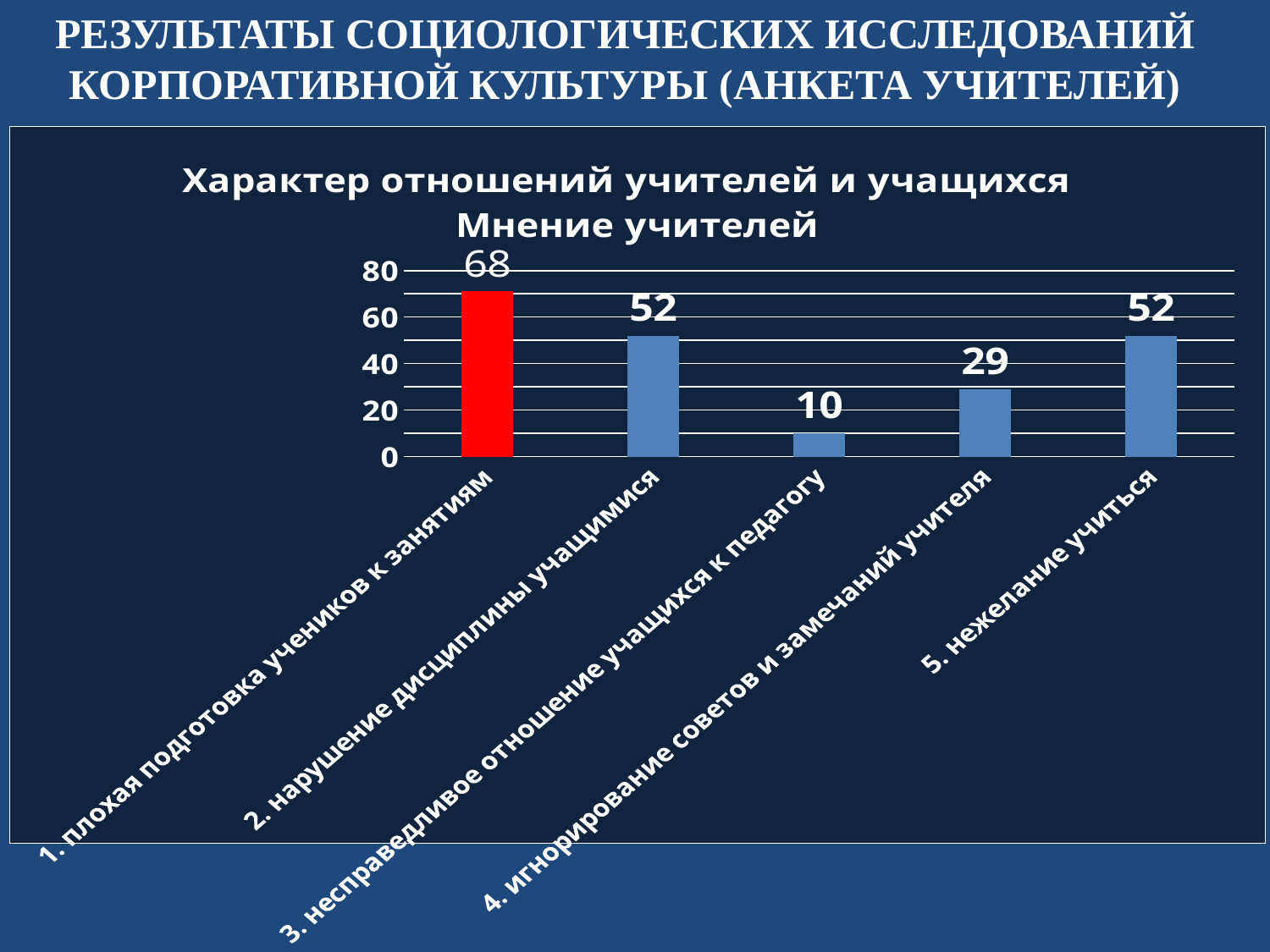
What is the value for "3. несправедливое отношение учащихся к педагогу"? 10 What is the difference between the values for "4. игнорирование советов и замечаний учителя" and "3. несправедливое отношение учащихся к педагогу"? 19 How many categories are shown in the chart? 5 Which category has the highest value? 1. плохая подготовка учеников к занятиям What is the value for "4. игнорирование советов и замечаний учителя"? 29 Which is larger: the value for "5. нежелание учиться" or the value for "4. игнорирование советов и замечаний учителя"? 5. нежелание учиться What is the difference between the values for "1. плохая подготовка учеников к занятиям" and "2. нарушение дисциплины учащимися"? 16 Which bar is coloured red? 1. плохая подготовка учеников к занятиям Is the value for "2. нарушение дисциплины учащимися" greater or less than 40? greater What is the value for "1. плохая подготовка учеников к занятиям"? 68 Which category has the lowest value? 3. несправедливое отношение учащихся к педагогу What kind of chart is shown on the slide? bar chart